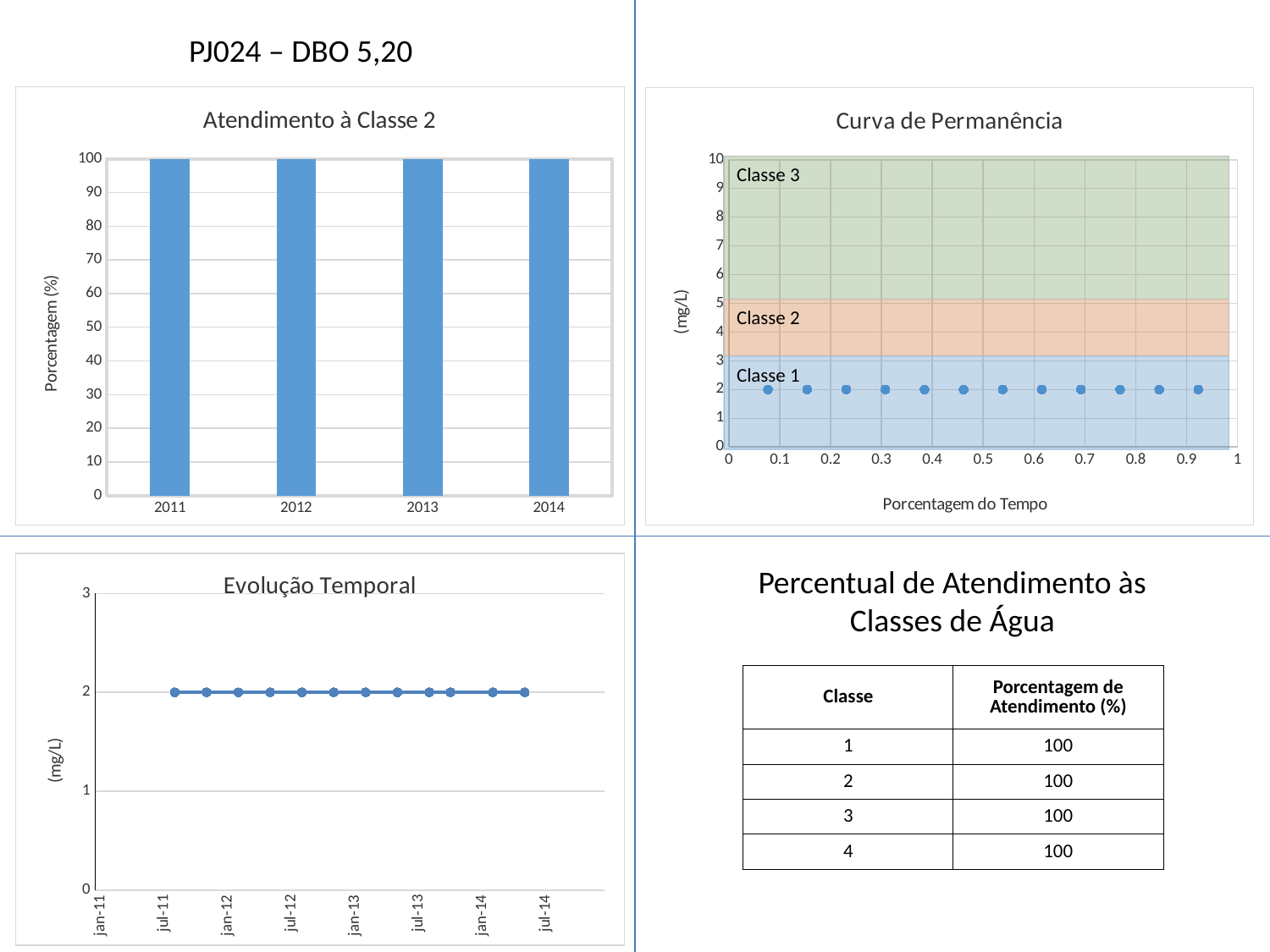
In the 'Evolução Temporal' chart, what value (mg/L) do the plotted points sit at? 2 In the 'Curva de Permanência' chart, are the plotted values greater or less than 3 mg/L? less In the 'Curva de Permanência' chart, how many data points are plotted? 12 In the 'Atendimento à Classe 2' chart, what is the label of the y axis? Porcentagem (%) In the 'Curva de Permanência' chart, are the plotted values greater or less than 1 mg/L? greater In the 'Curva de Permanência' chart, which class band do the plotted points fall in? Classe 1 In the 'Atendimento à Classe 2' chart, what is the value for 2014? 100 In the 'Evolução Temporal' chart, do the values rise, fall or stay flat over time? stay flat In the 'Atendimento à Classe 2' chart, what is the value for 2011? 100 In the 'Atendimento à Classe 2' chart, what is the difference between the values for 2012 and 2013? 0 What kind of chart is 'Atendimento à Classe 2'? bar chart In the 'Atendimento à Classe 2' chart, how many years are shown on the x axis? 4